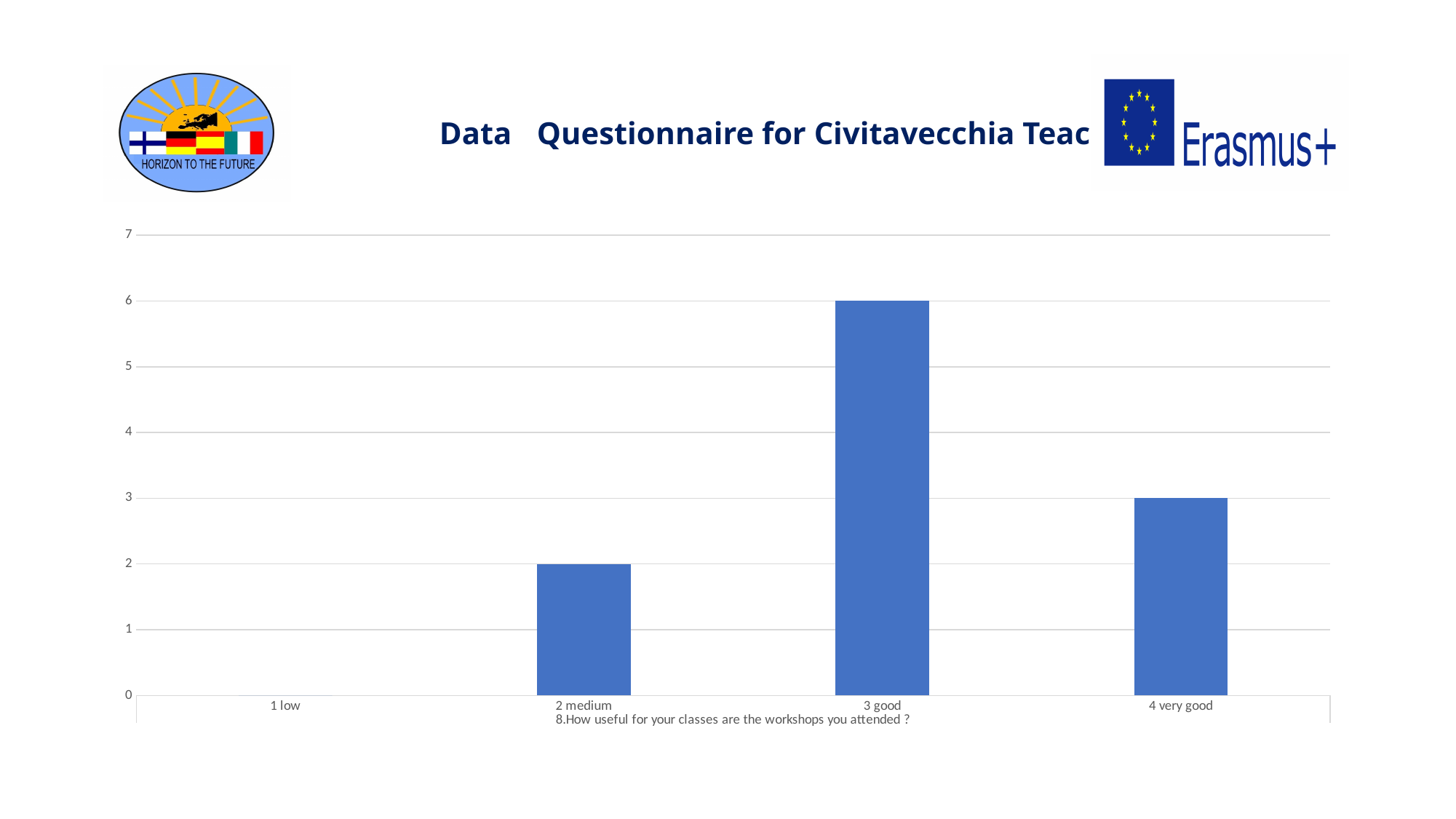
Is the value for "3 good" greater or less than 5? greater How many categories are shown on the x axis? 4 Which category has the lowest value? 1 low What is the value for "2 medium"? 2 What is the value for "3 good"? 6 What is the value for "4 very good"? 3 What is the difference between the values for "3 good" and "4 very good"? 3 What is the highest value shown on the vertical axis? 7 What type of chart is shown on the slide? bar chart What question is written as the x-axis title of the chart? 8.How useful for your classes are the workshops you attended ? Which is larger, the value for "2 medium" or the value for "4 very good"? 4 very good Which category has the highest value? 3 good